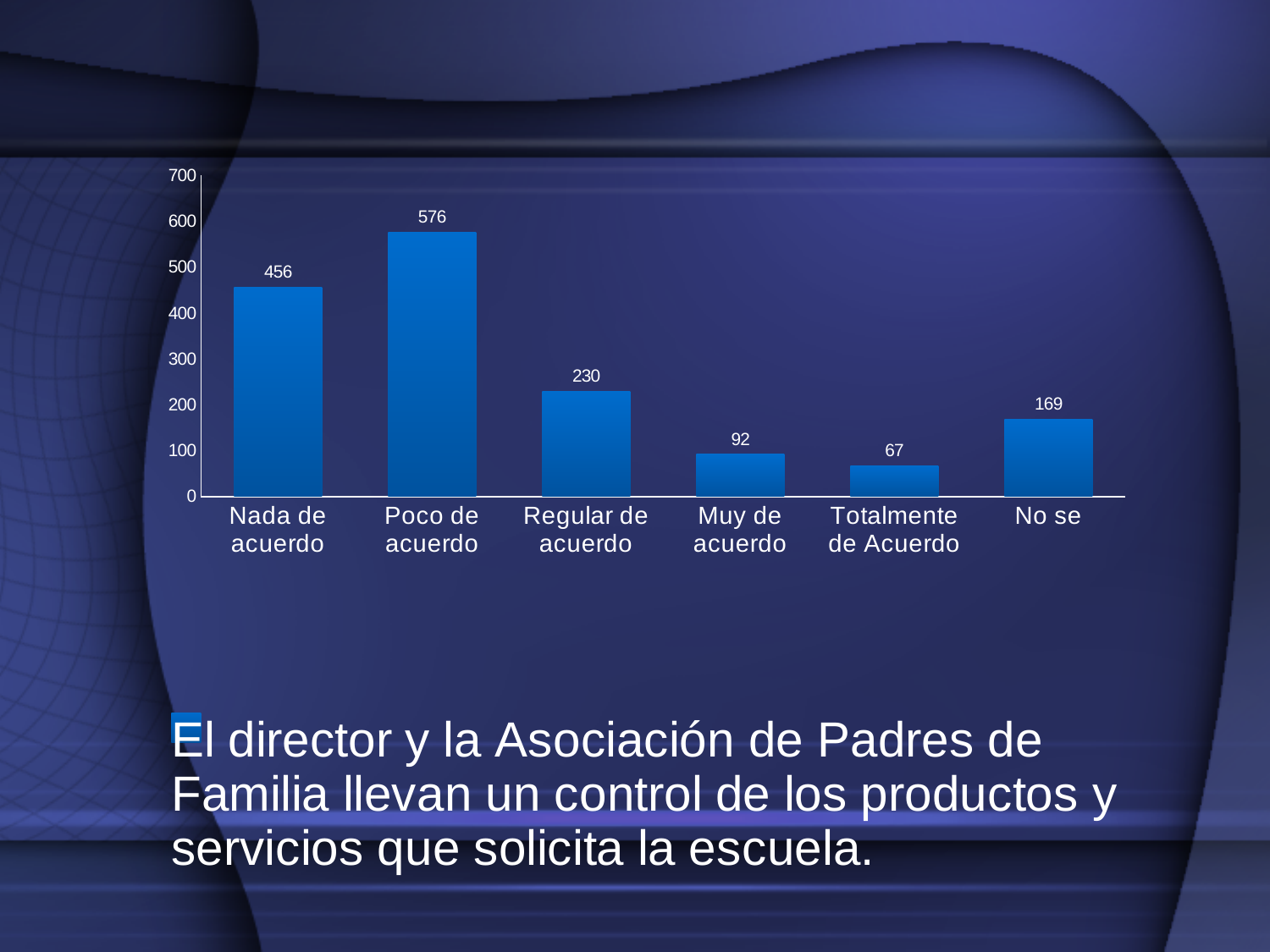
How many categories are shown on the x axis? 6 What kind of chart is shown on the slide? bar chart What is the value for "Totalmente de Acuerdo"? 67 What is the value for "Poco de acuerdo"? 576 Which category has the lowest value? Totalmente de Acuerdo What is the value for "No se"? 169 Which is larger, the value for "Muy de acuerdo" or the value for "No se"? No se Is the value for "Nada de acuerdo" greater or less than 400? greater What is the difference between the values for "Regular de acuerdo" and "No se"? 61 What is the highest value shown on the y axis? 700 Which category has the highest value? Poco de acuerdo What is the difference between the values for "Poco de acuerdo" and "Nada de acuerdo"? 120